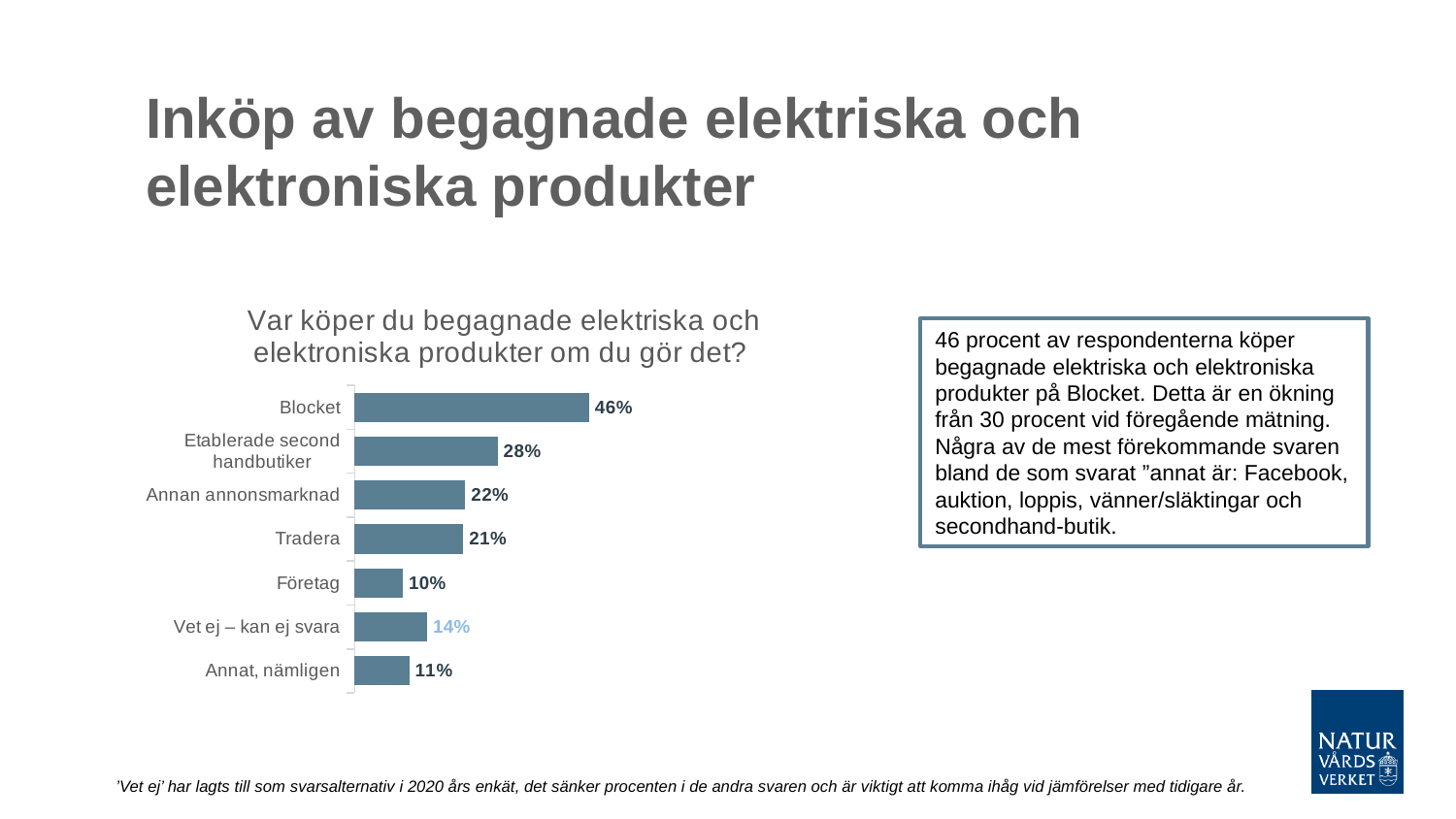
What is the value for Vet ej – kan ej svara? 14% What is the value for Blocket? 46% What kind of chart is shown on the slide? Bar chart How many categories are shown in the chart? 7 Which category has the lowest value? Företag What is the value for Tradera? 21% Which category has the highest value? Blocket What is the value for Etablerade second handbutiker? 28% What is the title of the chart? Var köper du begagnade elektriska och elektroniska produkter om du gör det? What is the difference between the values for Blocket and Etablerade second handbutiker? 18% Which is larger, the value for Företag or the value for Annat, nämligen? Annat, nämligen What is the difference between the values for Annan annonsmarknad and Tradera? 1%